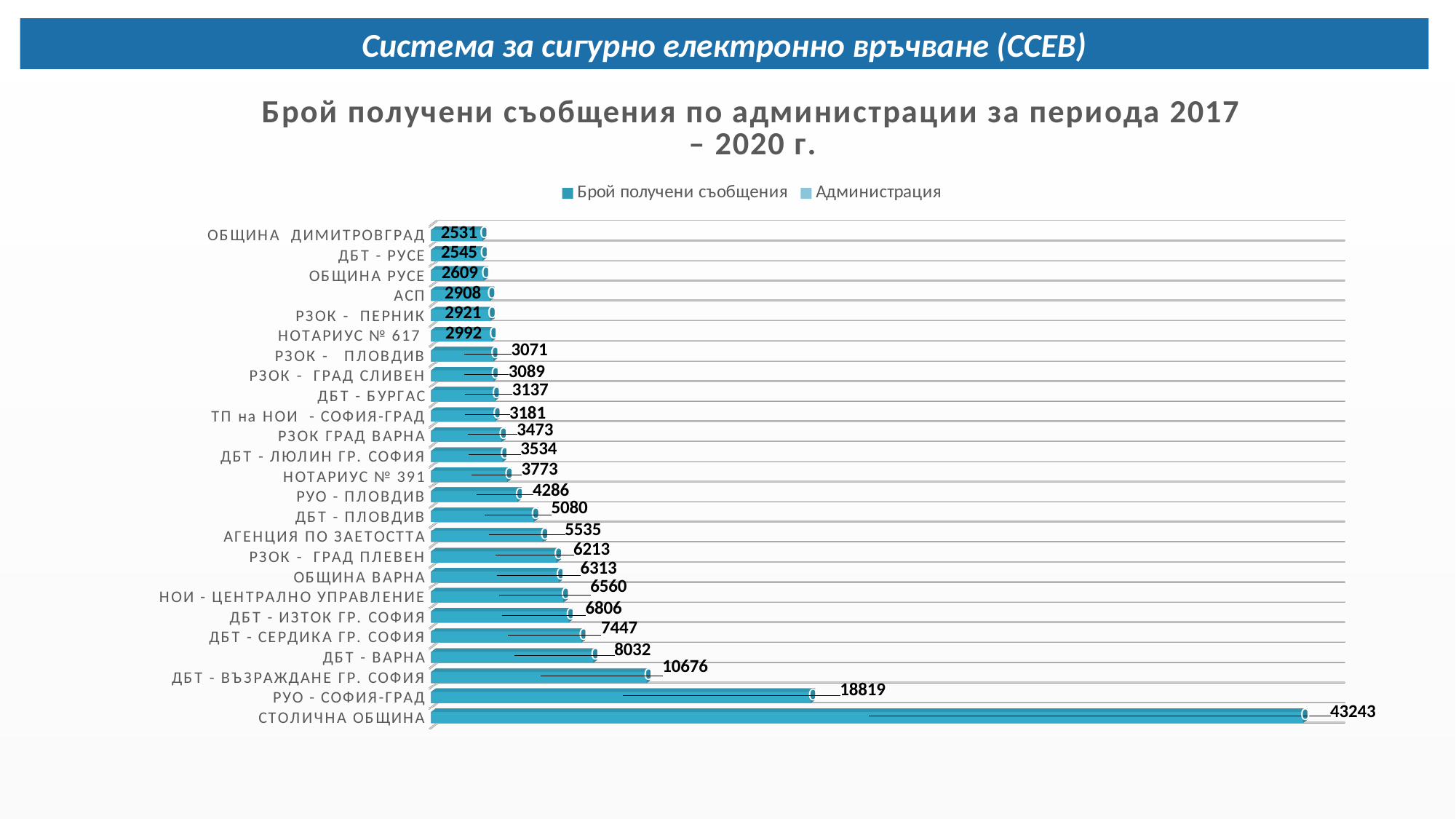
What is the difference between the values for СТОЛИЧНА ОБЩИНА and РУО - СОФИЯ-ГРАД? 24424 Which is larger, the value for ОБЩИНА ВАРНА or the value for РУО - ПЛОВДИВ? ОБЩИНА ВАРНА What is the value for ДБТ - ВАРНА? 8032 Which administration has the lowest number of received messages? ОБЩИНА ДИМИТРОВГРАД What is the value for СТОЛИЧНА ОБЩИНА? 43243 What is the difference between the values for ДБТ - ВАРНА and ДБТ - СЕРДИКА ГР. СОФИЯ? 585 Which administration has the highest number of received messages? СТОЛИЧНА ОБЩИНА What kind of chart is shown on the slide? Bar chart What is the value for АГЕНЦИЯ ПО ЗАЕТОСТТА? 5535 How many series does the legend list? 2 How many administrations are shown in the chart? 25 What is the value for НОТАРИУС № 391? 3773